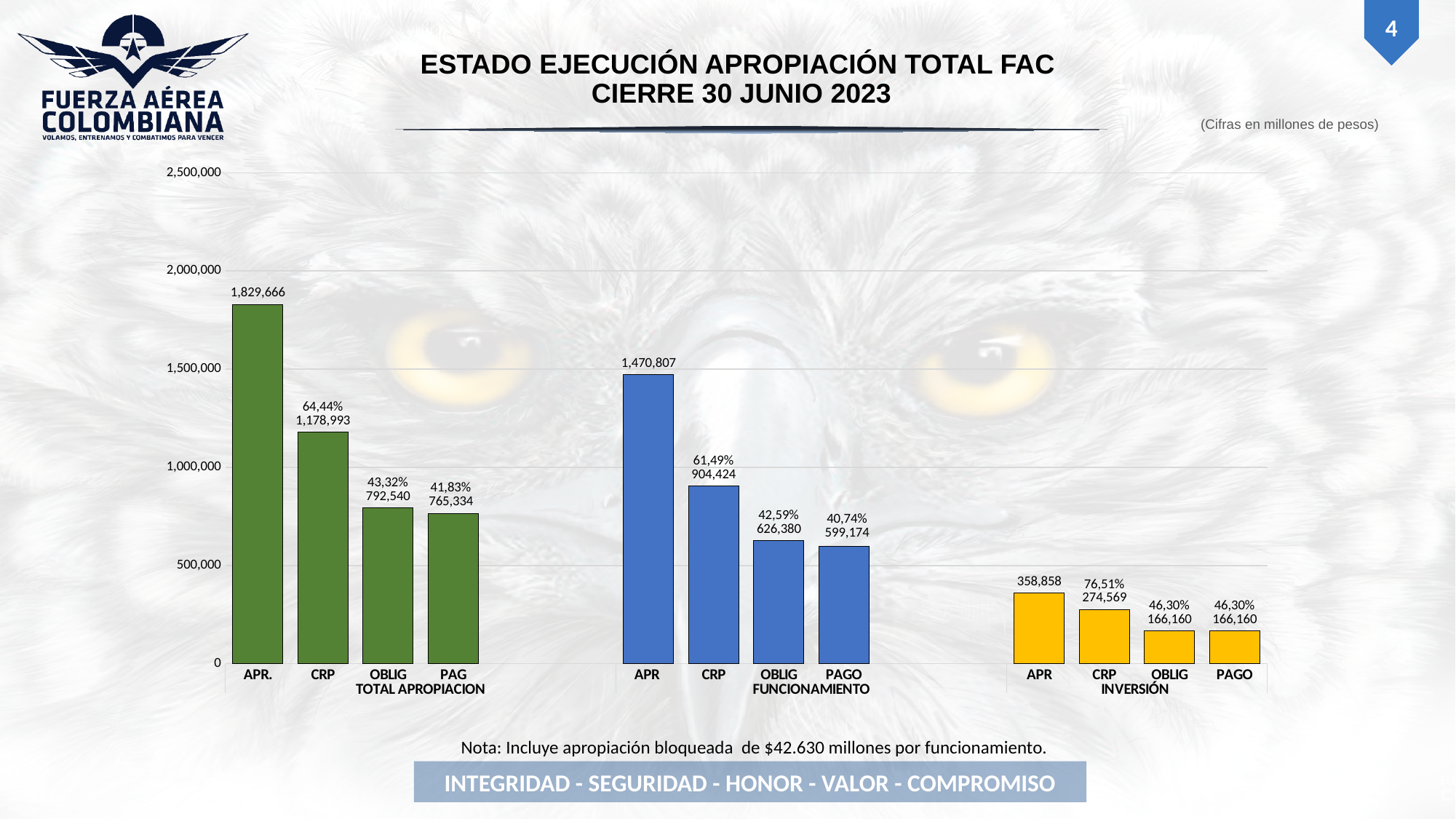
What is the value of the APR. bar in the TOTAL APROPIACION group? 1,829,666 What is the value of the CRP bar in the FUNCIONAMIENTO group? 904,424 What is the value of the PAGO bar in the INVERSIÓN group? 166,160 Is the value for APR in the FUNCIONAMIENTO group greater or less than 1,000,000? greater Which is larger: the OBLIG value in TOTAL APROPIACION or the CRP value in FUNCIONAMIENTO? CRP in FUNCIONAMIENTO What kind of chart is shown on the slide? bar chart What is the difference between the APR. value in TOTAL APROPIACION and the APR value in FUNCIONAMIENTO? 358,859 What is the difference between the APR and CRP values in the FUNCIONAMIENTO group? 566,383 How many bars are plotted on the chart in total? 12 What percentage is shown above the CRP bar in the INVERSIÓN group? 76,51% Which bar has the highest value on the chart? APR. in TOTAL APROPIACION Which bar has the lowest value within the FUNCIONAMIENTO group? PAGO